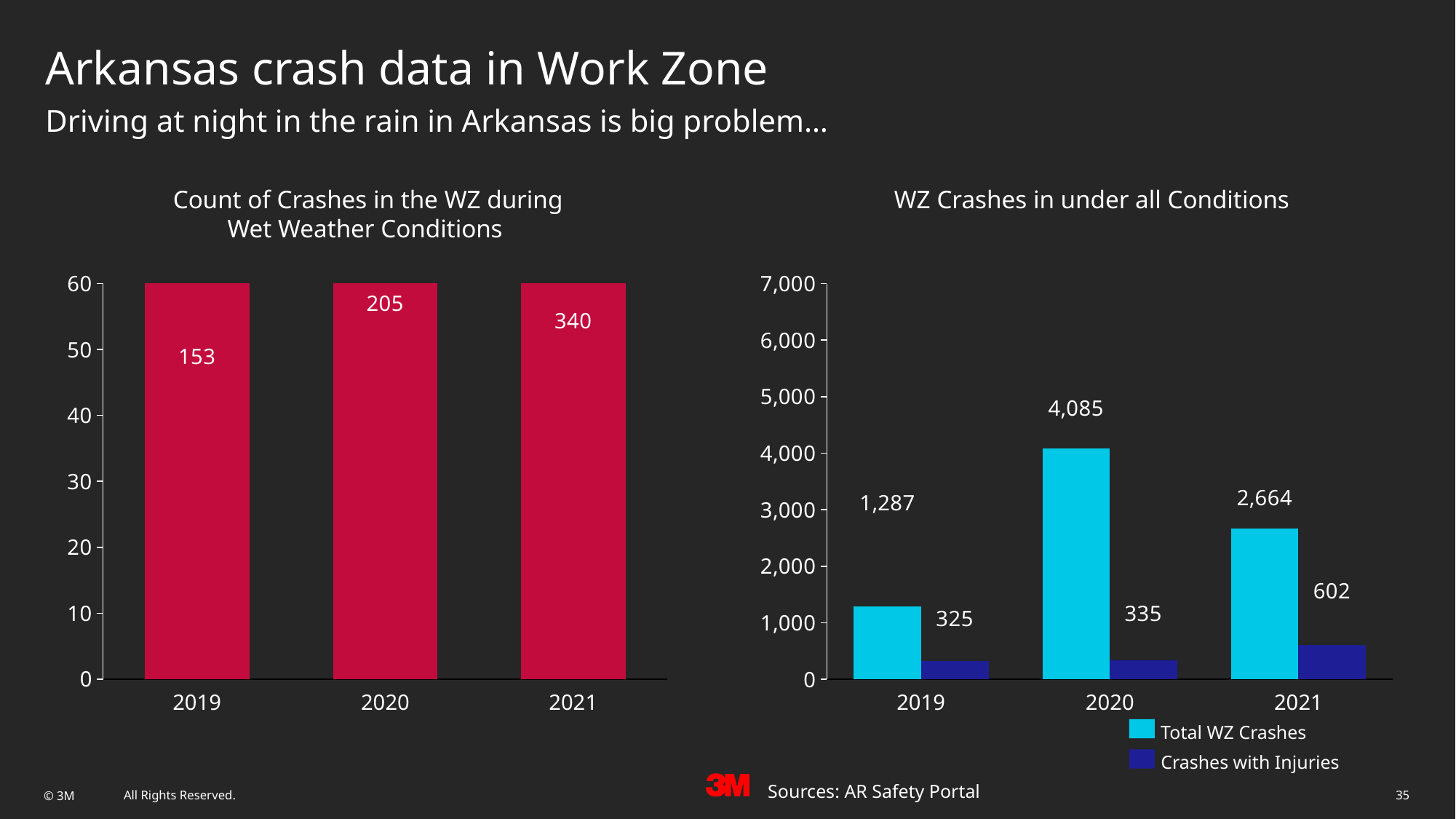
In the chart titled 'WZ Crashes in under all Conditions', what is the difference between Total WZ Crashes in 2020 and 2021? 1,421 In the chart titled 'WZ Crashes in under all Conditions', what is the value of Crashes with Injuries for 2021? 602 In the chart titled 'WZ Crashes in under all Conditions', is the Crashes with Injuries value for 2019 larger or smaller than the value for 2021? smaller In the chart titled 'Count of Crashes in the WZ during Wet Weather Conditions', which year has the lowest value? 2019 In the chart titled 'WZ Crashes in under all Conditions', what is the value of Total WZ Crashes for 2020? 4,085 In the chart titled 'Count of Crashes in the WZ during Wet Weather Conditions', what is the value for 2020? 205 How many series does the legend of the chart titled 'WZ Crashes in under all Conditions' list? 2 What kind of chart is the chart titled 'WZ Crashes in under all Conditions'? bar chart In the chart titled 'Count of Crashes in the WZ during Wet Weather Conditions', do the values rise or fall from 2019 to 2021? rise In the chart titled 'Count of Crashes in the WZ during Wet Weather Conditions', what is the difference between the 2021 and 2019 values? 187 In the chart titled 'Count of Crashes in the WZ during Wet Weather Conditions', which year has the highest value? 2021 In the chart titled 'WZ Crashes in under all Conditions', which year has the highest Total WZ Crashes? 2020